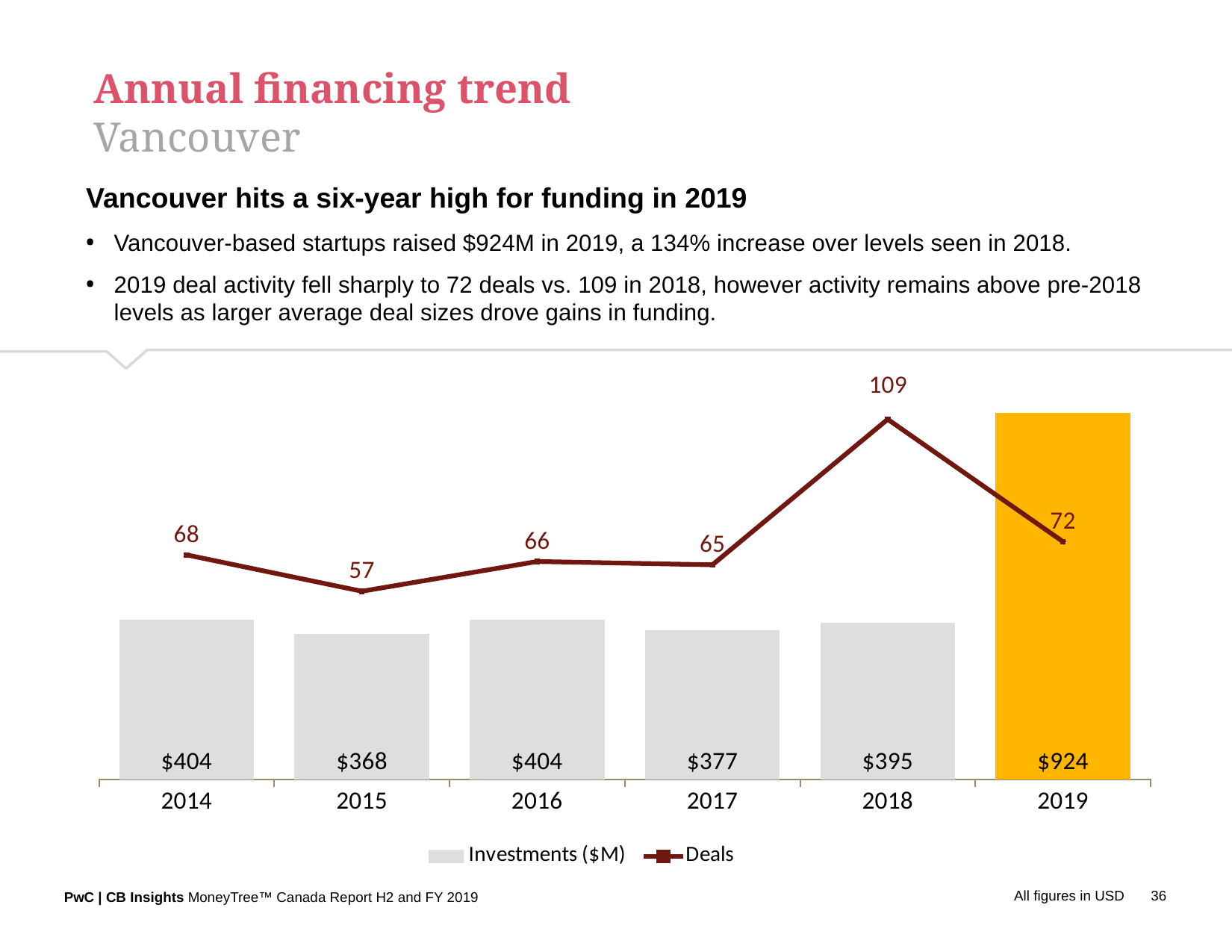
How many years are shown on the x axis? 6 What is the difference in Deals between 2018 and 2019? 37 What was the value of Investments ($M) in 2019? $924 Which year had the highest number of Deals? 2018 What is the difference in Investments ($M) between 2019 and 2018? $529 Which bar is highlighted in a different colour (orange) from the others? 2019 Which year had the lowest number of Deals? 2015 Which year had the lowest Investments ($M)? 2015 Were Investments ($M) higher in 2014 or in 2017? 2014 How many Deals were there in 2018? 109 What was the value of Investments ($M) in 2015? $368 How many series does the legend list? 2